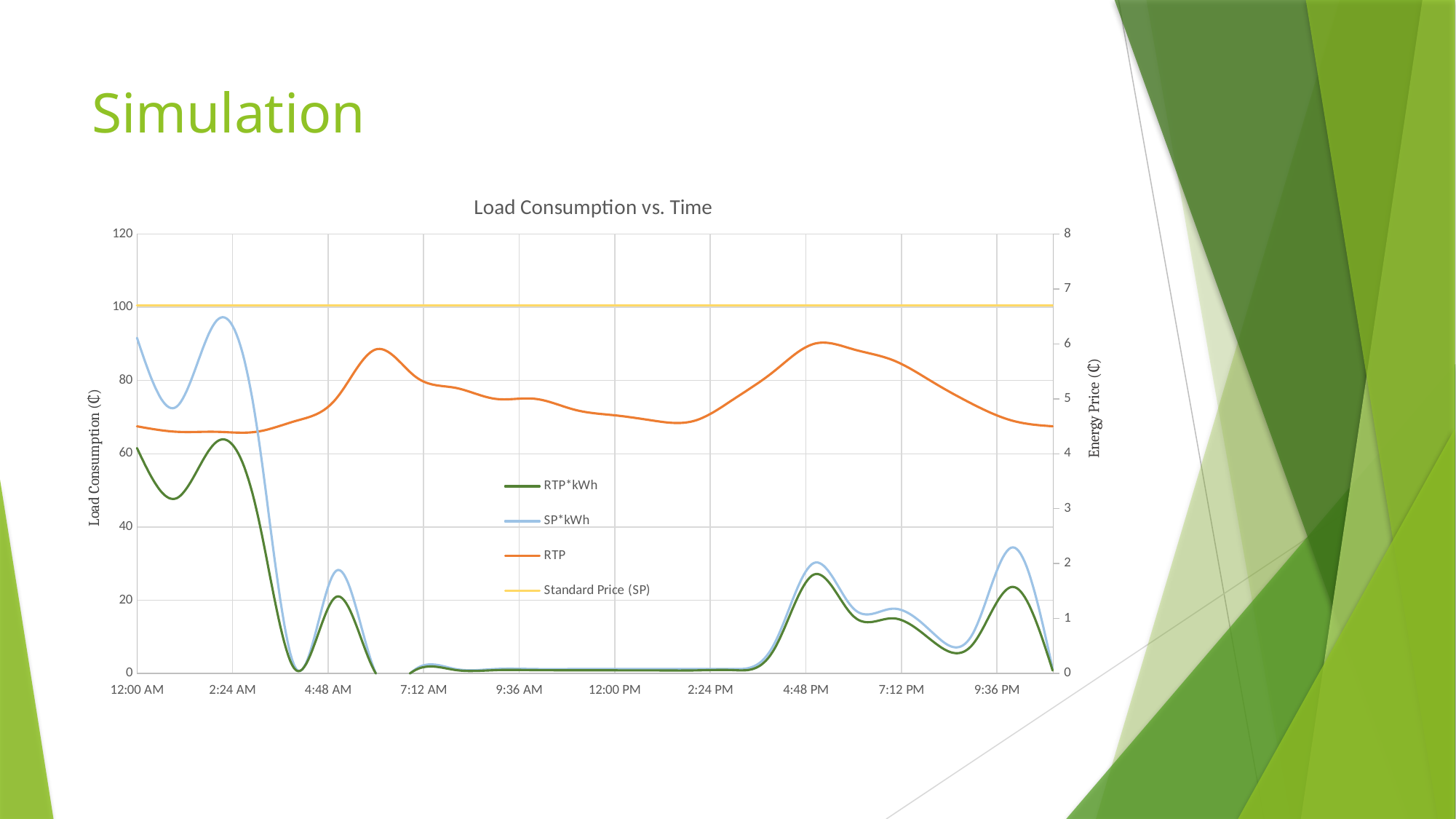
What kind of chart is shown on the slide? line chart At 2:24 AM, which is larger: SP*kWh or RTP*kWh? SP*kWh Is the value of SP*kWh at 12:00 AM greater or less than 80 on the left axis? greater Which of the two series RTP*kWh and SP*kWh reaches the higher peak? SP*kWh What is the title of the chart? Load Consumption vs. Time How many time labels are shown on the x axis? 10 Is the RTP value at 12:00 AM greater or less than 5 on the right axis? less Does the RTP line rise or fall between 2:24 PM and 4:48 PM? rise Is the value of RTP*kWh at 12:00 AM greater or less than 40 on the left axis? greater How many series does the legend list? 4 What colour is the RTP line in the chart? orange